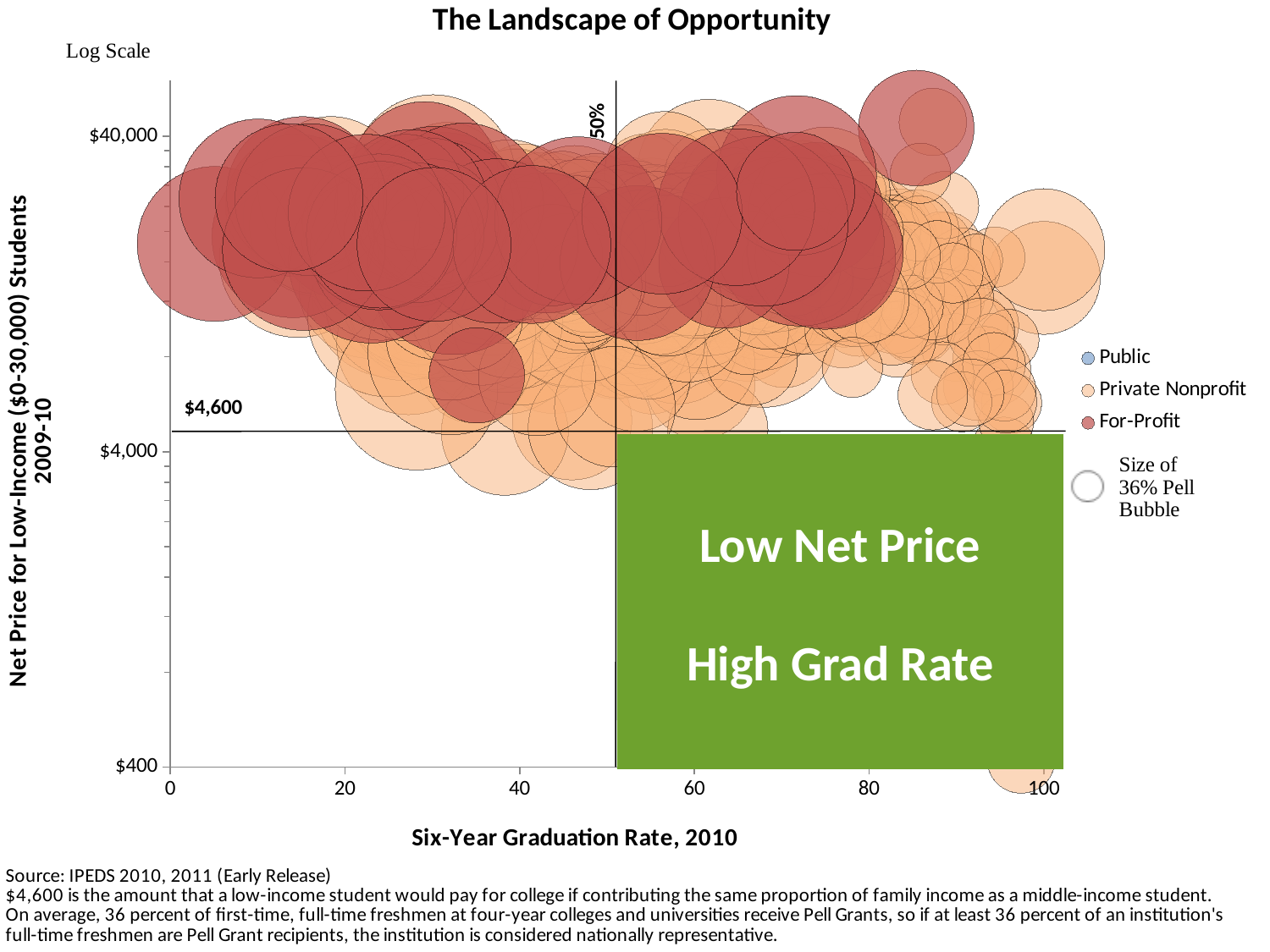
How many series does the legend list? 3 What Pell percentage does the reference bubble in the legend represent? 36% What is the highest tick value shown on the y axis? $40,000 What is the lowest tick value shown on the y axis? $400 What scale is used for the y axis? Log Scale What graduation rate is marked by the vertical reference line on the chart? 50% What does the green box in the lower-right quadrant of the chart say? Low Net Price High Grad Rate What is the title of the chart? The Landscape of Opportunity What is the label of the x axis? Six-Year Graduation Rate, 2010 What value is marked by the horizontal reference line on the chart? $4,600 What kind of chart is shown on the slide? Bubble chart Which legend series is shown in red? For-Profit